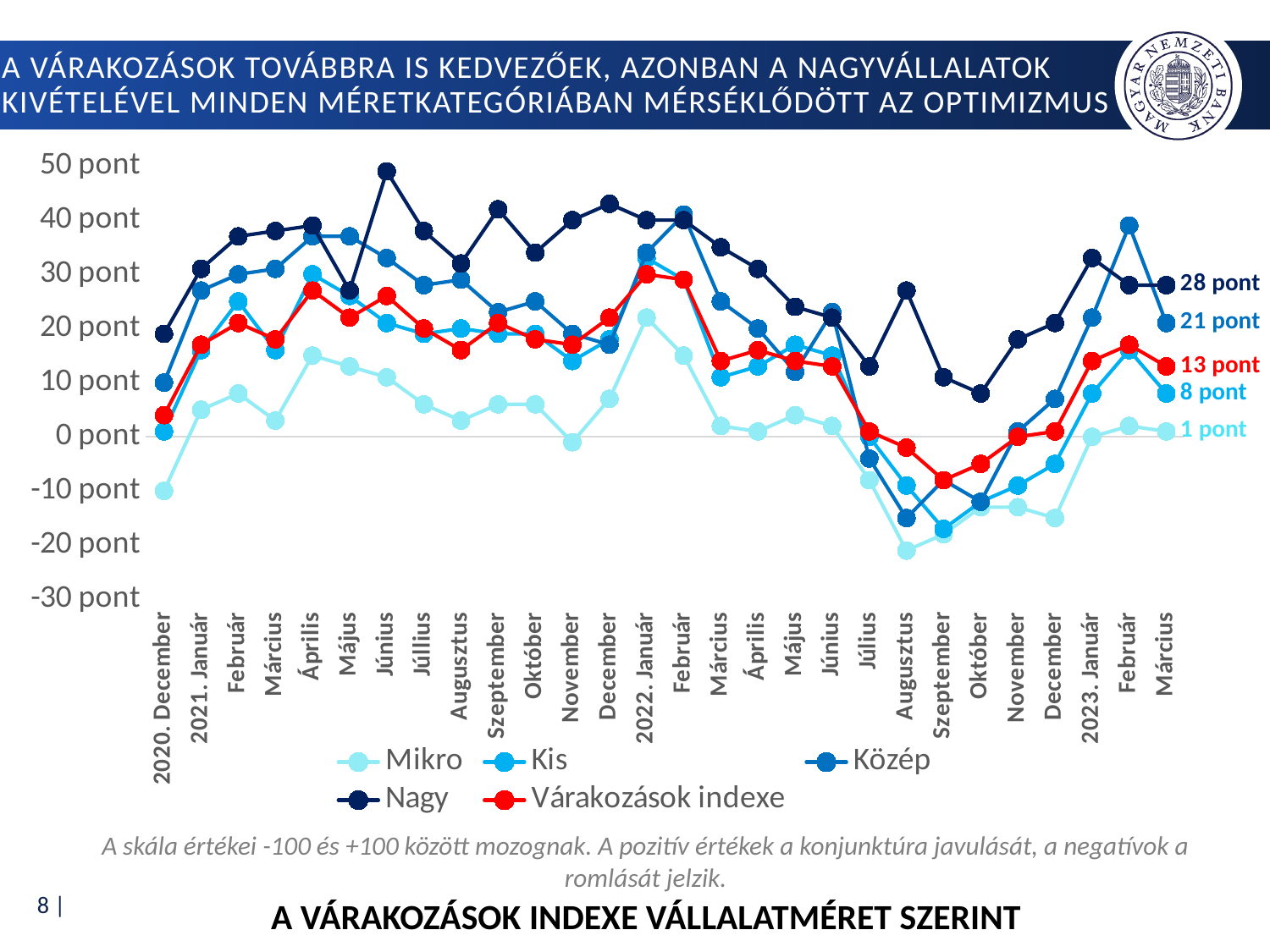
What kind of chart is shown on the slide? line chart What is the difference between the Nagy and Mikro values in 2023 Március? 27 pont What is the value of the Várakozások indexe series in 2023 Március? 13 pont Which series has the lowest value in 2023 Március? Mikro Which series has the highest value in 2023 Március? Nagy How many months are plotted along the x axis? 28 What is the value of the Nagy series in 2023 Március? 28 pont What is the value of the Kis series in 2023 Március? 8 pont What is the value of the Mikro series in 2023 Március? 1 pont How many series does the legend list? 5 Is the value of the Nagy series in 2021 Június greater or less than 40 pont? greater What is the value of the Közép series in 2023 Március? 21 pont